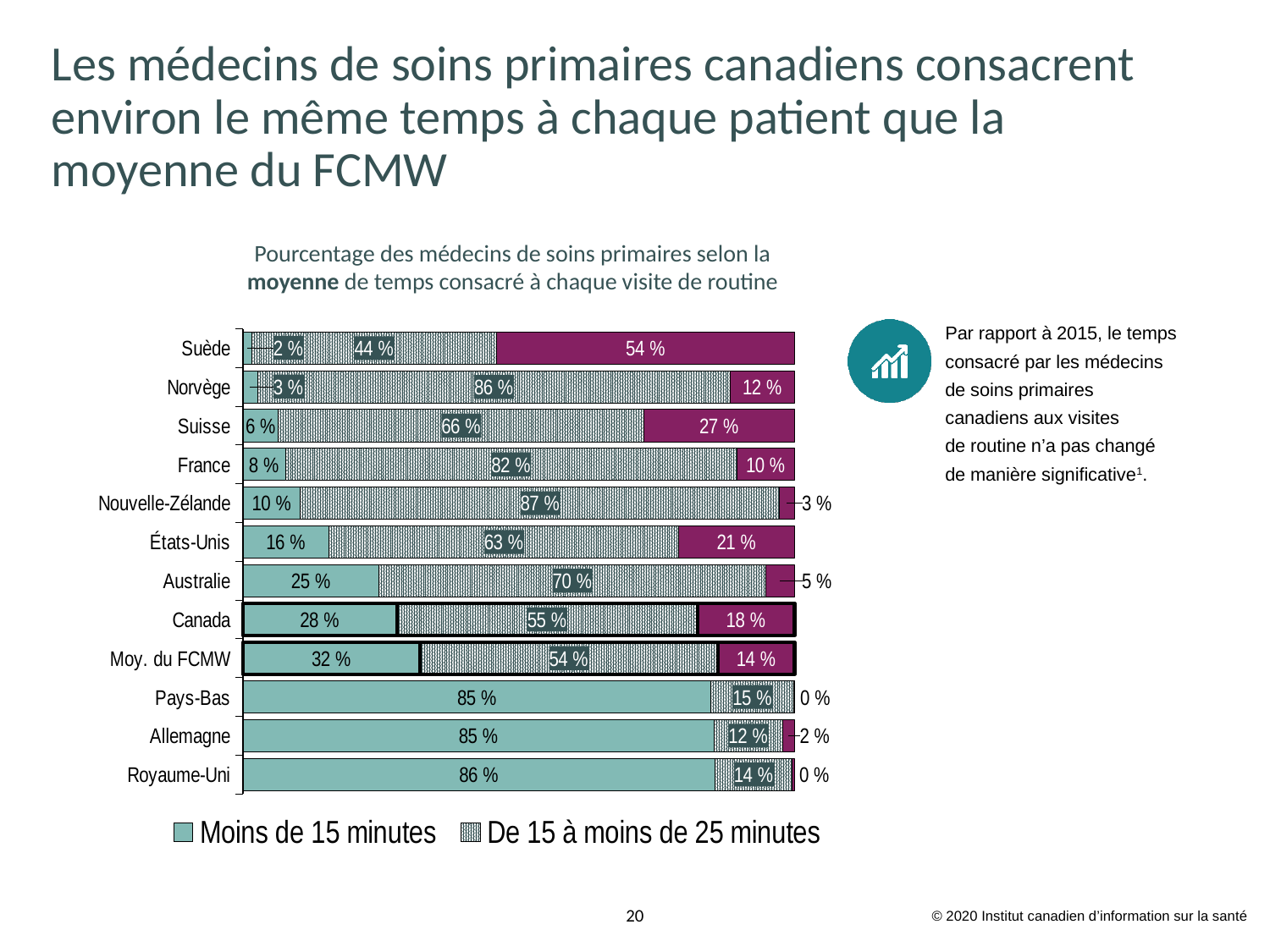
What is the value for Canada in the 'Moins de 15 minutes' series? 28 % How many countries or categories are listed on the chart? 12 What is the value for Nouvelle-Zélande in the 'De 15 à moins de 25 minutes' series? 87 % Which category has the highest value in the 'Moins de 15 minutes' series? Royaume-Uni What is the total of the stacked bar for Suède? 100 % What is the value for Moy. du FCMW in the 'De 15 à moins de 25 minutes' series? 54 % What is the difference between Moy. du FCMW and Canada in the 'Moins de 15 minutes' series? 4 % How many series does the chart legend list? 2 What is the first legend entry of the chart? Moins de 15 minutes Which category has the lowest value in the 'Moins de 15 minutes' series? Suède Which is larger in the 'De 15 à moins de 25 minutes' series: Norvège or France? Norvège What type of chart is shown on the slide? Stacked bar chart